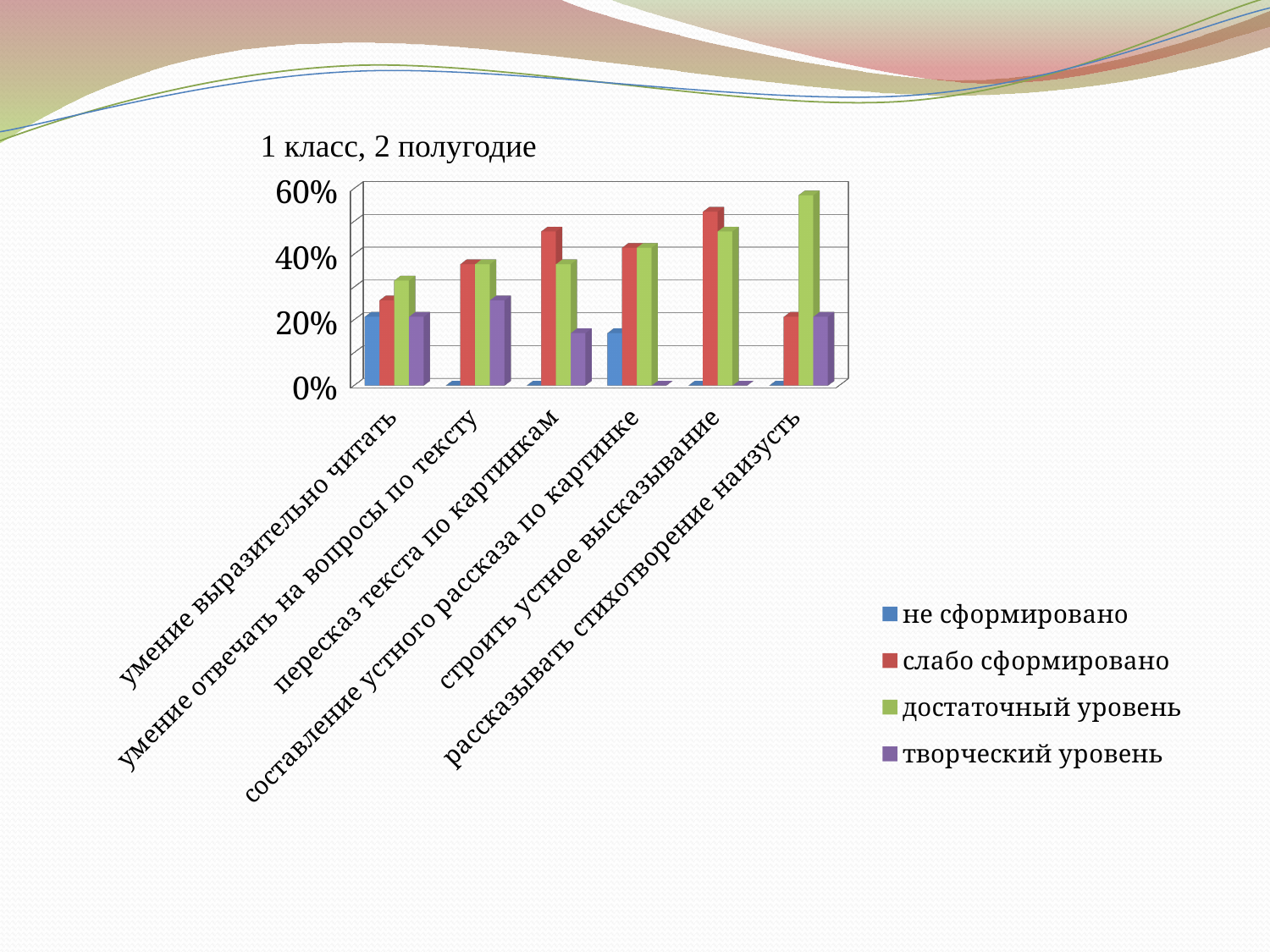
How many categories are shown on the x axis of the chart? 6 Is the value of "слабо сформировано" for "строить устное высказывание" greater or less than 40%? greater Is the value of "творческий уровень" for "пересказ текста по картинкам" greater or less than 20%? less What kind of chart is shown on the slide? bar chart Is the value of "не сформировано" for "составление устного рассказа по картинке" greater or less than 20%? less For which category is the "достаточный уровень" bar the highest? рассказывать стихотворение наизусть Which colour represents the series "творческий уровень" in the legend? purple How many series does the legend list? 4 Which series has the highest value for "пересказ текста по картинкам"? слабо сформировано What is the title of the chart? 1 класс, 2 полугодие For "умение выразительно читать", which is larger: "достаточный уровень" or "не сформировано"? достаточный уровень